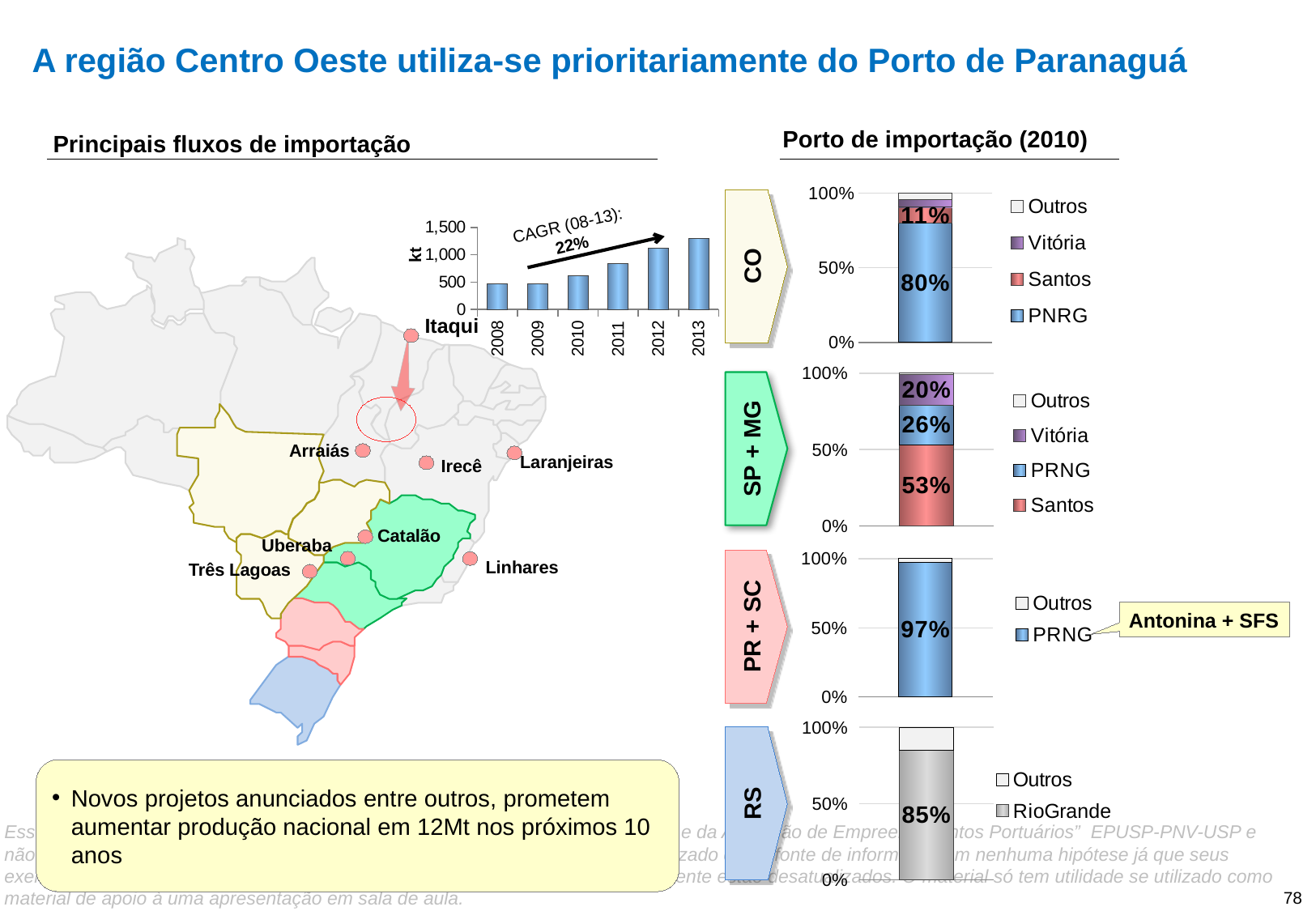
In the SP + MG chart, what share is labelled for Vitória? 20% In the CO chart under 'Porto de importação (2010)', what share is labelled for PNRG? 80% How many entries does the legend of the CO chart list? 4 In the PR + SC chart, what share is labelled for PRNG? 97% In the SP + MG chart, what share is labelled for Santos? 53% In the SP + MG chart, which port has the largest labelled share? Santos In the small kt bar chart above the map, how many years are plotted? 6 In the small kt bar chart above the map, do the values generally rise or fall from 2008 to 2013? rise In the small kt bar chart above the map, is the value for 2013 greater or less than 1,000? greater In the RS chart, what share is labelled for RioGrande? 85% In the CO chart, what share is labelled for Santos? 11% In the SP + MG chart, what is the difference between the Santos share and the PRNG share? 27%